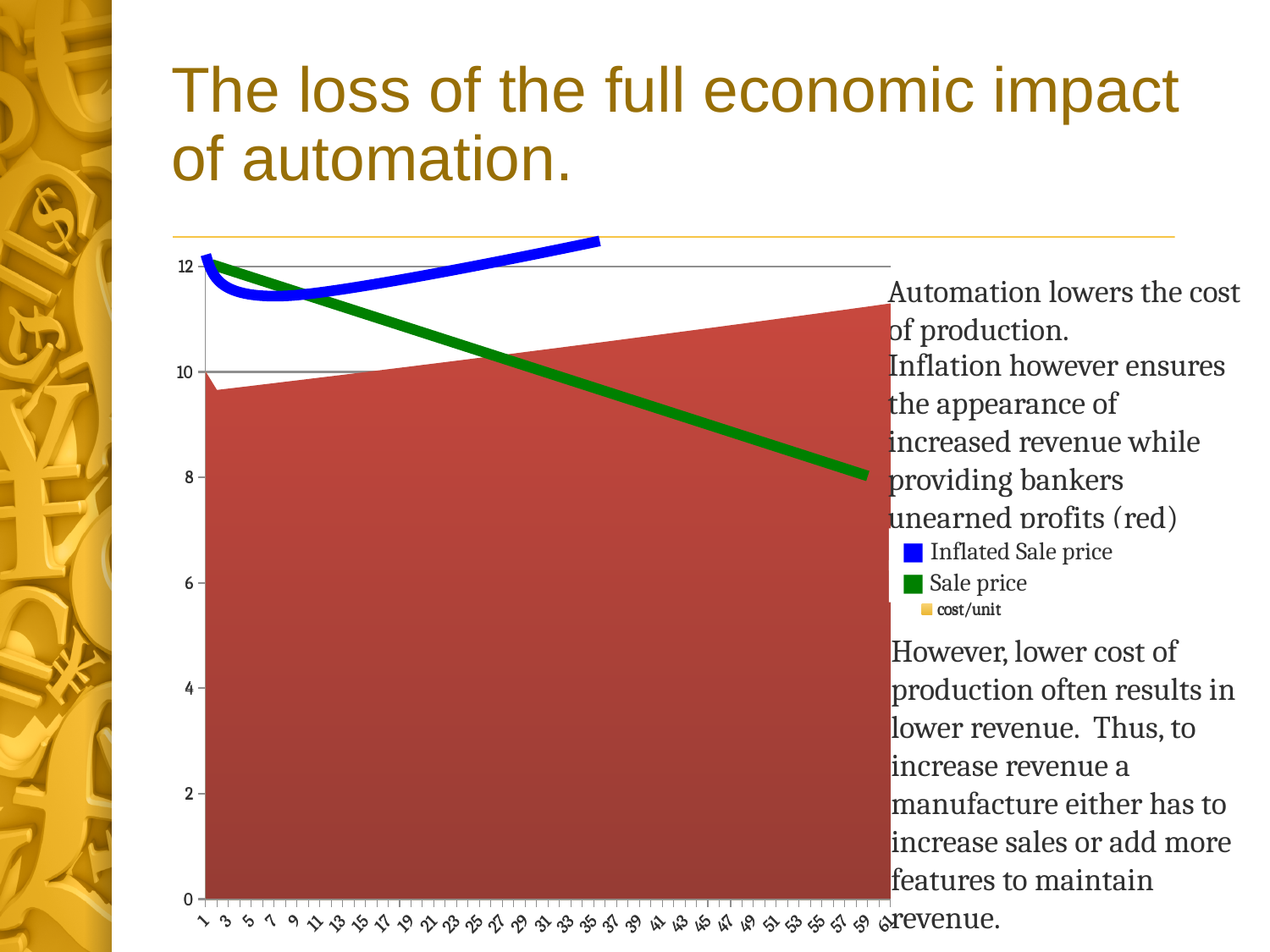
What is the Sale price value at x = 61? 8 Is the Inflated Sale price value at x = 11 greater or less than 12? less By how much does the Sale price fall between x = 1 and x = 61? 4 Which colour represents the Sale price series in the legend? green At x = 31, which is larger: the Inflated Sale price or the Sale price? Inflated Sale price How many series does the chart legend list? 3 Is the Sale price value at x = 41 greater or less than 10? less What is the Sale price value at x = 1? 12 What kind of chart is used for the cost/unit series? area chart Does the Sale price series rise or fall along the x axis? fall